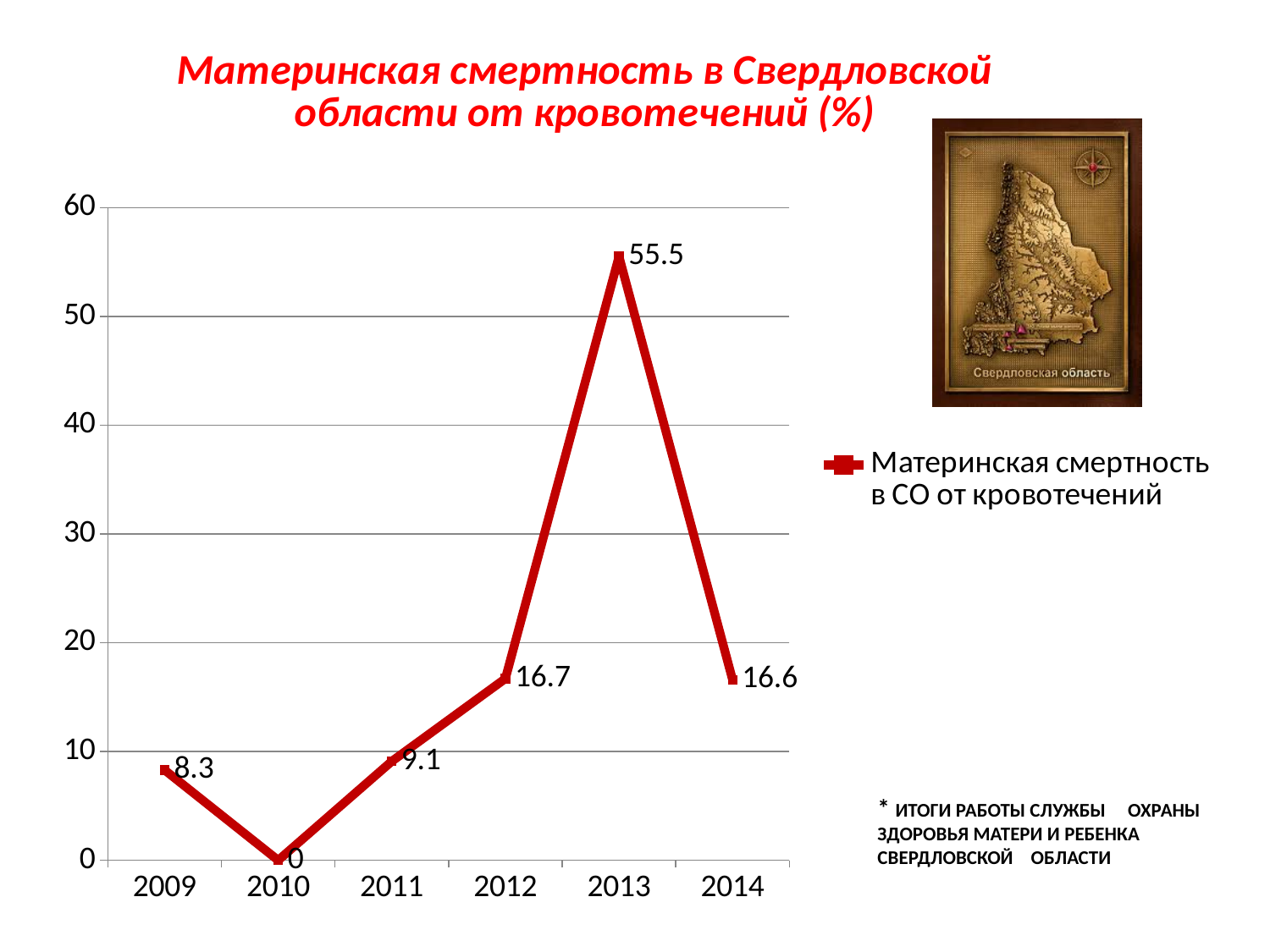
Is the value for 2013 greater or less than 50? greater What is the value for 2012? 16.7 What is the difference between the values for 2013 and 2014? 38.9 What is the value for 2014? 16.6 Which is larger, the value for 2011 or the value for 2009? 2011 What is the value for 2013? 55.5 What kind of chart is shown on the slide? line chart Does the value rise or fall from 2013 to 2014? fall Which year has the highest value? 2013 What is the value for 2009? 8.3 How many years are plotted on the chart? 6 Which year has the lowest value? 2010